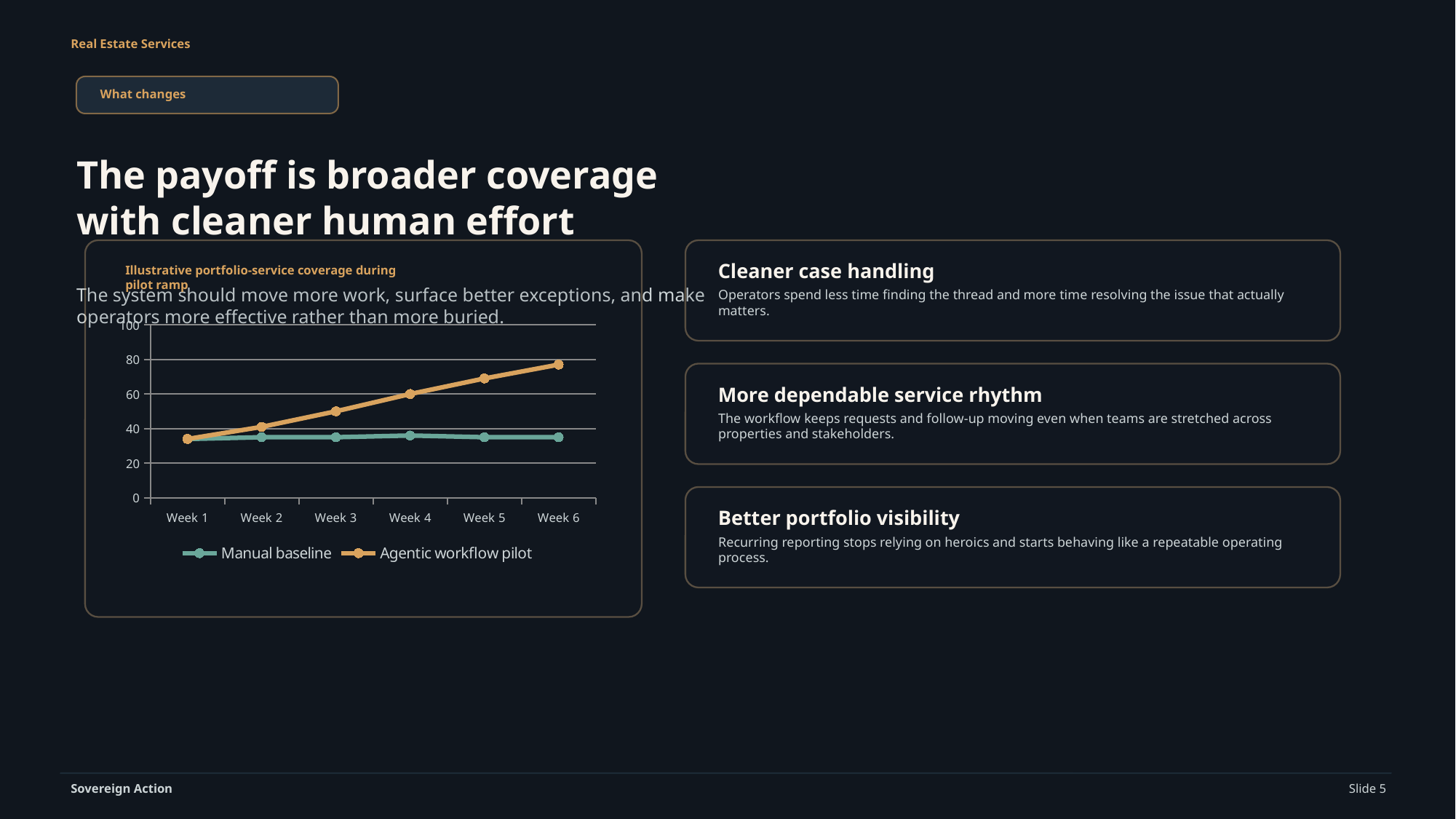
Is the value for Agentic workflow pilot in Week 6 greater or less than 100? less Is the value for Agentic workflow pilot in Week 6 greater or less than 60? greater What kind of chart is shown on the slide? line chart Does the Agentic workflow pilot series rise or fall from Week 1 to Week 6? rise How many weeks are plotted along the x axis of the chart? 6 Which series has the higher value in Week 5, Manual baseline or Agentic workflow pilot? Agentic workflow pilot Is the value for Manual baseline in Week 6 greater or less than 40? less How many series does the chart legend list? 2 In which week does the Agentic workflow pilot series reach its highest value? Week 6 Which series is drawn in orange in the chart? Agentic workflow pilot What is the title of the chart? Illustrative portfolio-service coverage during pilot ramp